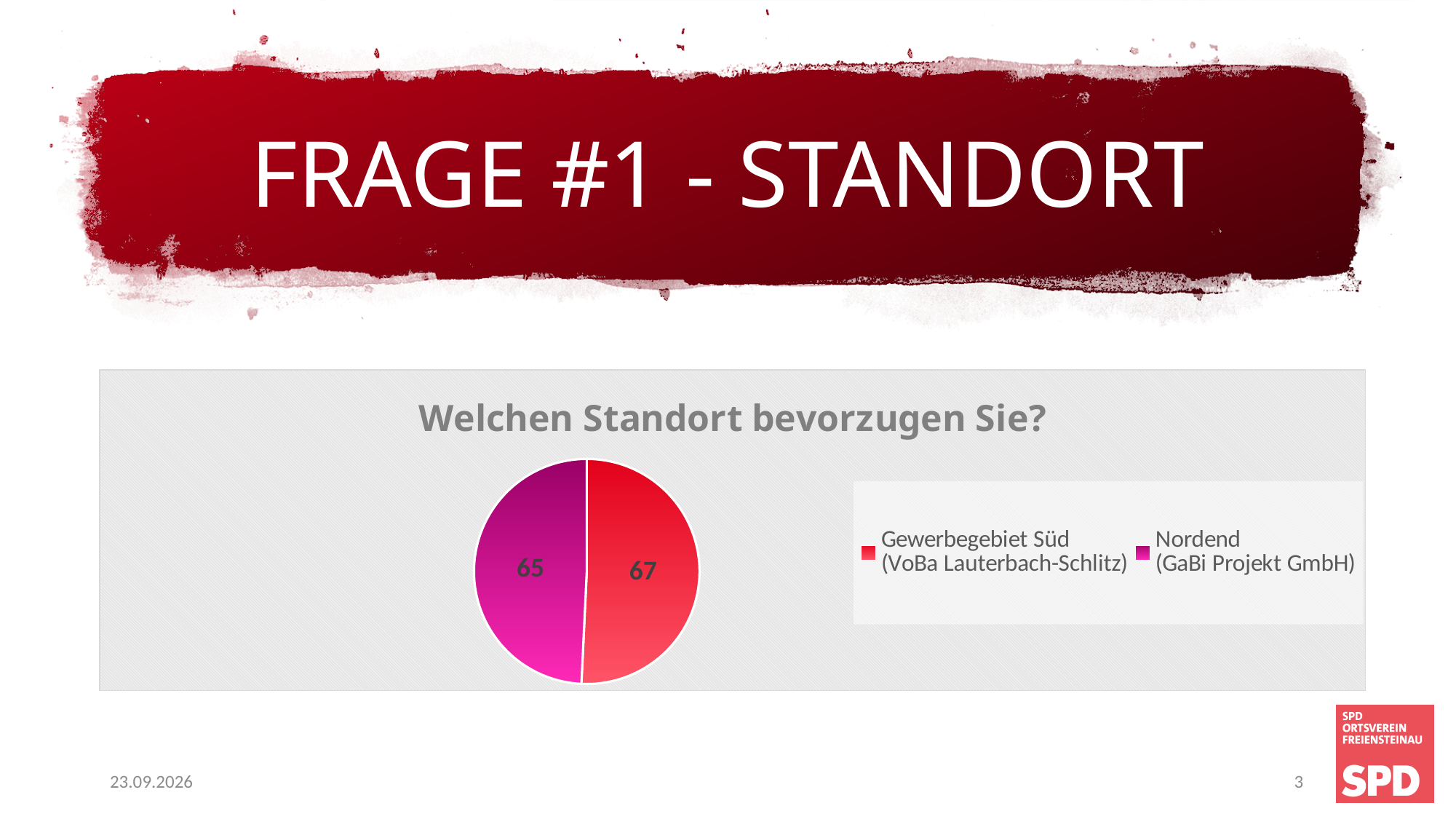
What is the title of the chart? Welchen Standort bevorzugen Sie? What is the value for Nordend (GaBi Projekt GmbH)? 65 Which location received the fewest votes? Nordend (GaBi Projekt GmbH) What is the total of the two values shown in the pie chart? 132 Which location received the most votes? Gewerbegebiet Süd (VoBa Lauterbach-Schlitz) Which has a larger value, Gewerbegebiet Süd or Nordend? Gewerbegebiet Süd How many slices does the pie chart have? 2 What is the value for Gewerbegebiet Süd (VoBa Lauterbach-Schlitz)? 67 What is the difference between the values for Gewerbegebiet Süd and Nordend? 2 What kind of chart is shown on the slide? pie chart Which colour represents Nordend (GaBi Projekt GmbH) in the chart? purple/magenta How many entries does the legend list? 2